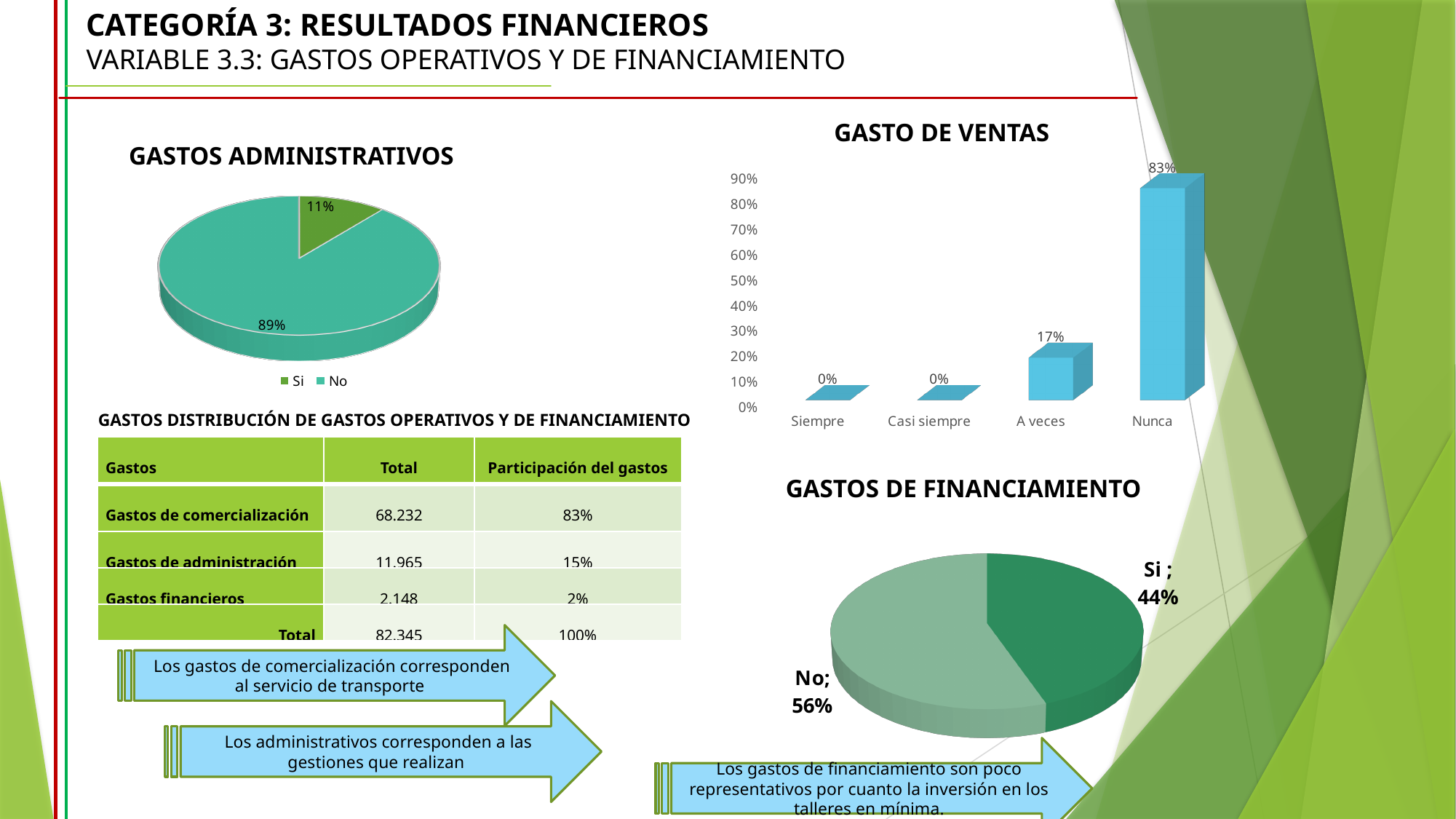
In the GASTO DE VENTAS chart, which category has the highest value? Nunca In the GASTO DE VENTAS chart, what is the value for A veces? 17% In the GASTOS DE FINANCIAMIENTO pie chart, what share does the "Si" slice have? 44% In the GASTO DE VENTAS chart, what is the value for Nunca? 83% In the GASTOS ADMINISTRATIVOS pie chart, what share does the "Si" slice have? 11% In the GASTO DE VENTAS chart, what is the difference between the values for Nunca and A veces? 66% In the GASTOS ADMINISTRATIVOS chart, which slice is larger, Si or No? No In the GASTOS DE FINANCIAMIENTO pie chart, which slice is larger, Si or No? No What kind of chart is GASTOS ADMINISTRATIVOS? Pie chart How many categories are shown on the x axis of the GASTO DE VENTAS chart? 4 What kind of chart is GASTO DE VENTAS? Bar chart In the GASTOS ADMINISTRATIVOS pie chart, what share does the "No" slice have? 89%